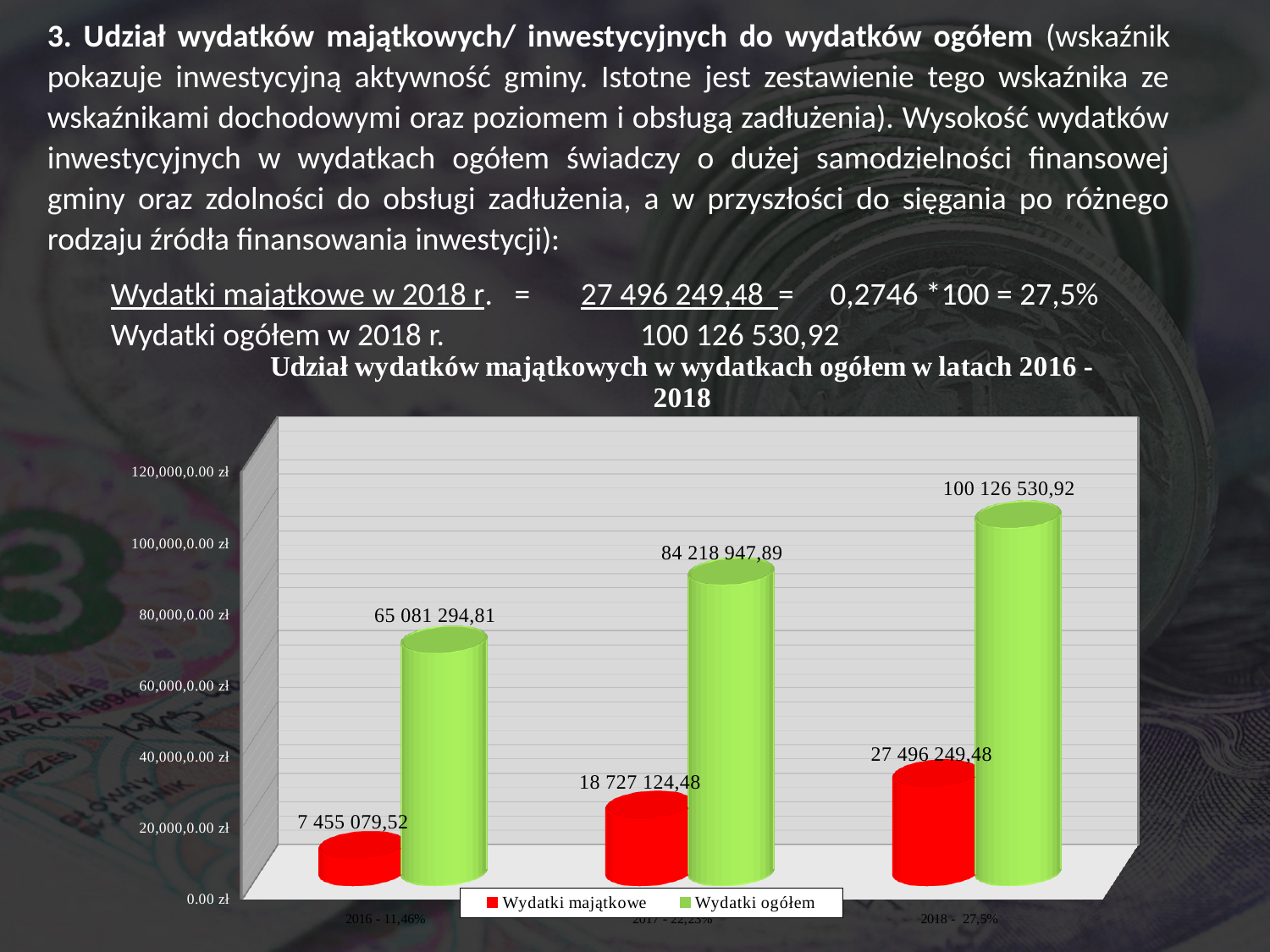
What is the value of Wydatki ogółem for 2018? 100 126 530,92 What is the value of Wydatki majątkowe for 2017? 18 727 124,48 How many series does the legend list? 2 Do the values of Wydatki ogółem rise or fall from 2016 to 2018? rise In which year is Wydatki majątkowe the lowest? 2016 What is the value of Wydatki majątkowe for 2016? 7 455 079,52 By how much did Wydatki majątkowe increase from 2016 to 2018? 20 041 169,96 What type of chart is shown on the slide? bar chart What is the value of Wydatki ogółem for 2016? 65 081 294,81 Which is larger: Wydatki majątkowe in 2018 or Wydatki majątkowe in 2017? Wydatki majątkowe in 2018 What is the difference between Wydatki ogółem and Wydatki majątkowe in 2018? 72 630 281,44 In which year is Wydatki ogółem the highest? 2018